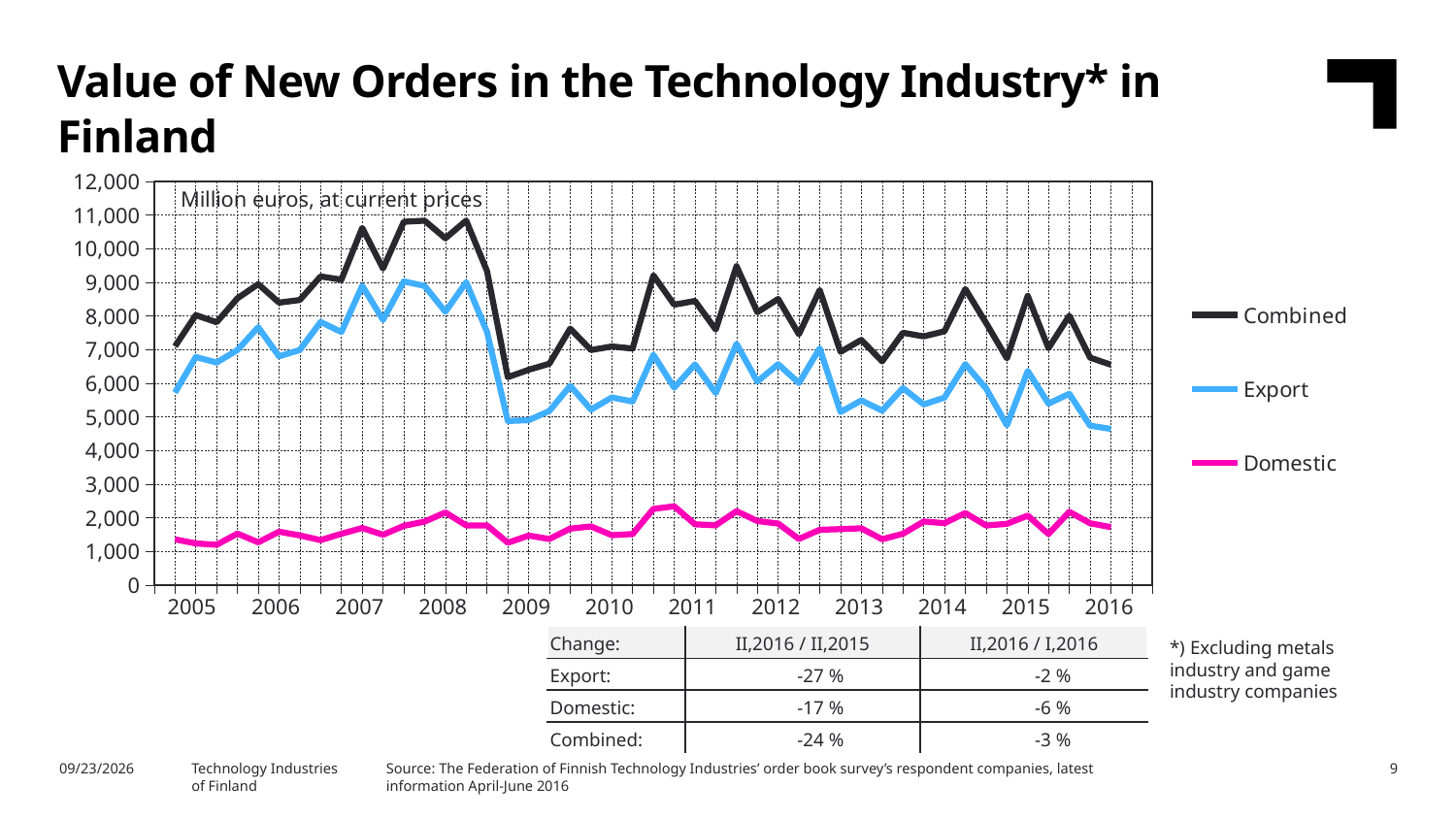
How many series does the legend list? 3 Is the lowest value for Combined in 2009 greater or less than 7,000? less Which series has the highest values across the whole chart? Combined Does the Combined series rise or fall from 2015 to 2016? fall Is the value for Combined at the start of 2005 greater or less than 6,000? greater What kind of chart is shown on the slide? Line chart What unit label is printed inside the plot area? Million euros, at current prices Is the value for Domestic in 2016 greater or less than 3,000? less What are the series names listed in the legend? Combined, Export, Domestic Which series has the lowest values across the whole chart? Domestic How many years are labelled on the x axis? 12